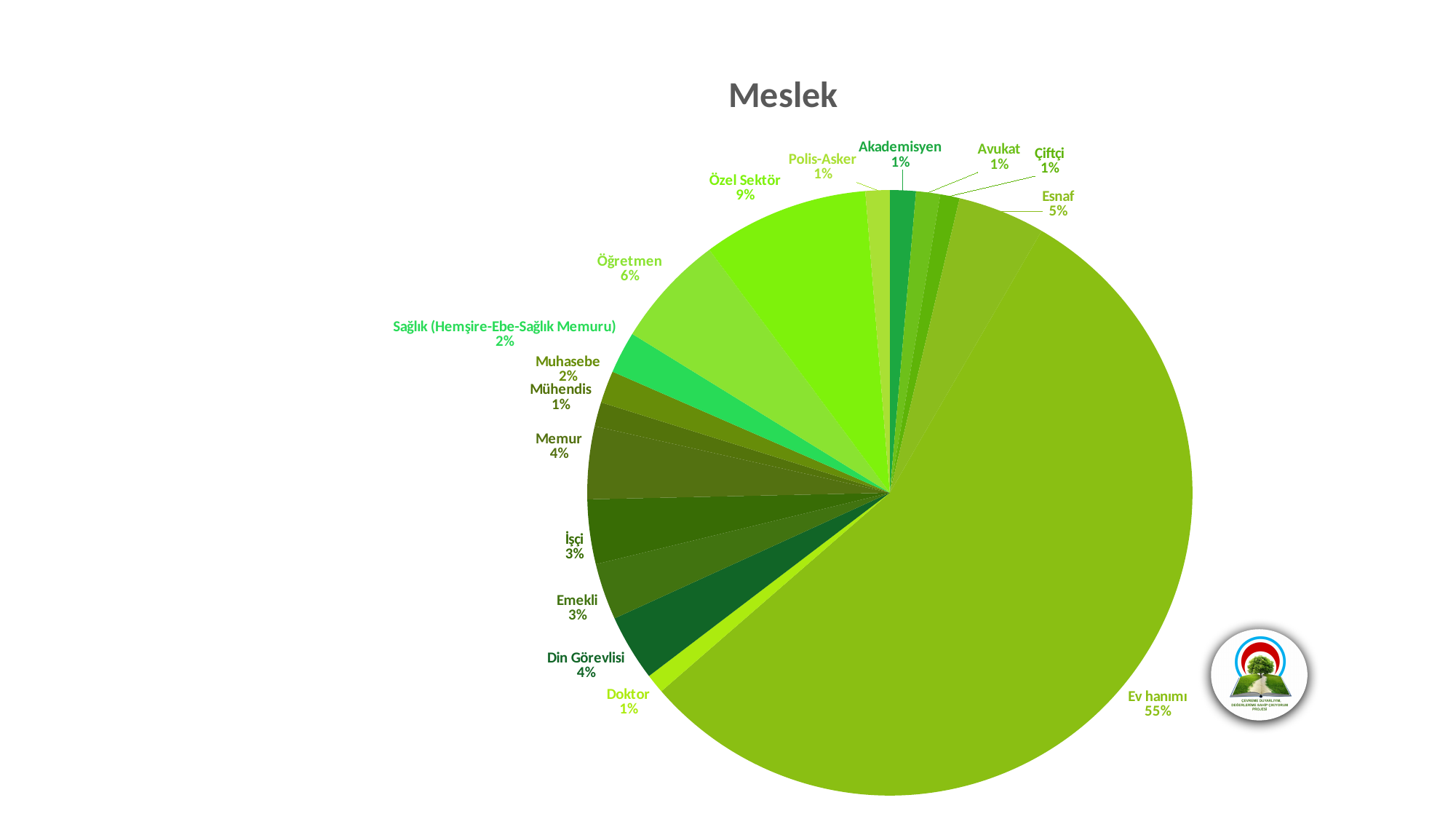
What is the title of the chart? Meslek Which category has the largest slice of the pie? Ev hanımı What is the value for Esnaf? 5% What is the difference between the values for Özel Sektör and Öğretmen? 3% What share of the pie does Ev hanımı have? 55% Which is larger, the value for Memur or the value for Emekli? Memur What is the value for Öğretmen? 6% What kind of chart is shown on the slide? pie chart What is the value for Özel Sektör? 9% What is the value for Sağlık (Hemşire-Ebe-Sağlık Memuru)? 2% How many categories are shown in the pie chart? 16 What is the value for Din Görevlisi? 4%